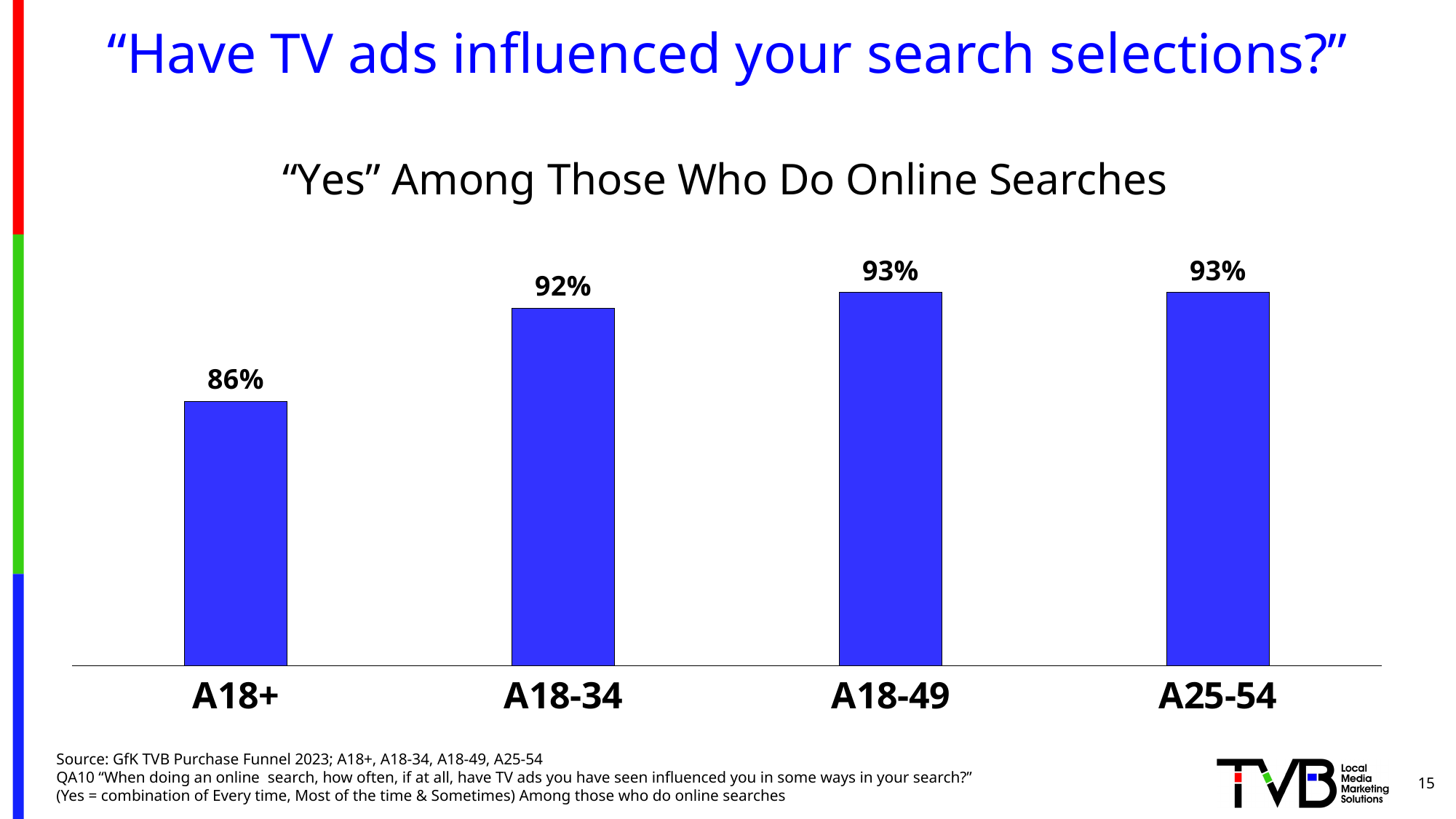
What colour are the bars in the chart? blue What is the value for A25-54? 93% What is the title of the chart? "Yes" Among Those Who Do Online Searches How many categories are shown on the chart? 4 Which category has the lowest value? A18+ What is the value for A18-34? 92% What is the difference between the values for A18-49 and A18+? 7% What is the value for A18-49? 93% What is the value for A18+? 86% Which is larger, the value for A18+ or the value for A18-34? A18-34 What is the difference between the values for A18-34 and A18+? 6% What kind of chart is shown on the slide? bar chart